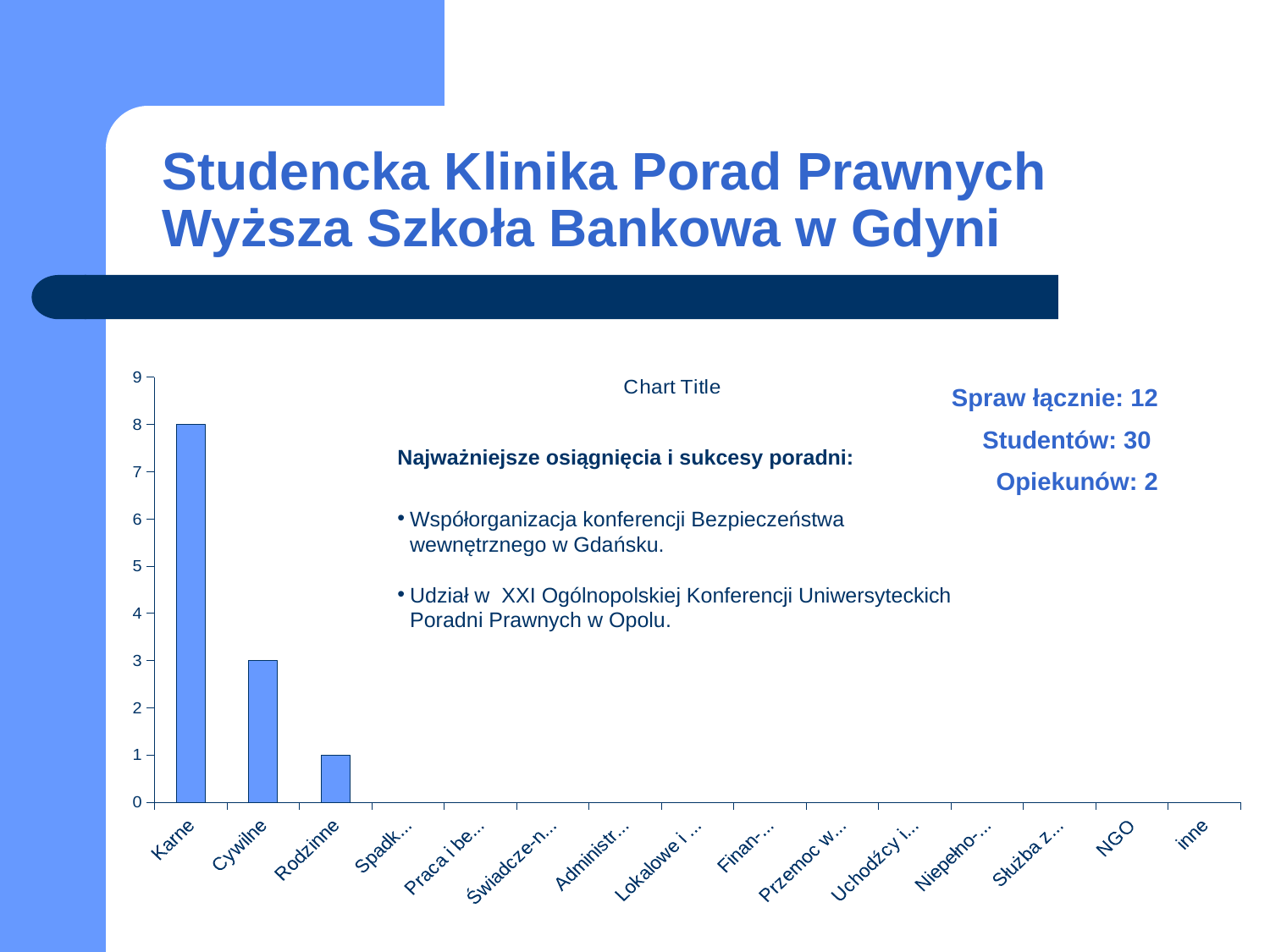
What is the title of the chart? Chart Title What is the value for Karne? 8 Which is larger, the value for Karne or the value for Cywilne? Karne How many categories are shown on the x axis? 15 What is the value for Cywilne? 3 What is the value for Rodzinne? 1 What is the difference between the values for Cywilne and Rodzinne? 2 Which is larger, the value for Rodzinne or the value for Cywilne? Cywilne Is the value for Karne greater or less than 5? greater Which category has the highest value? Karne What is the difference between the values for Karne and Cywilne? 5 What kind of chart is shown on the slide? bar chart